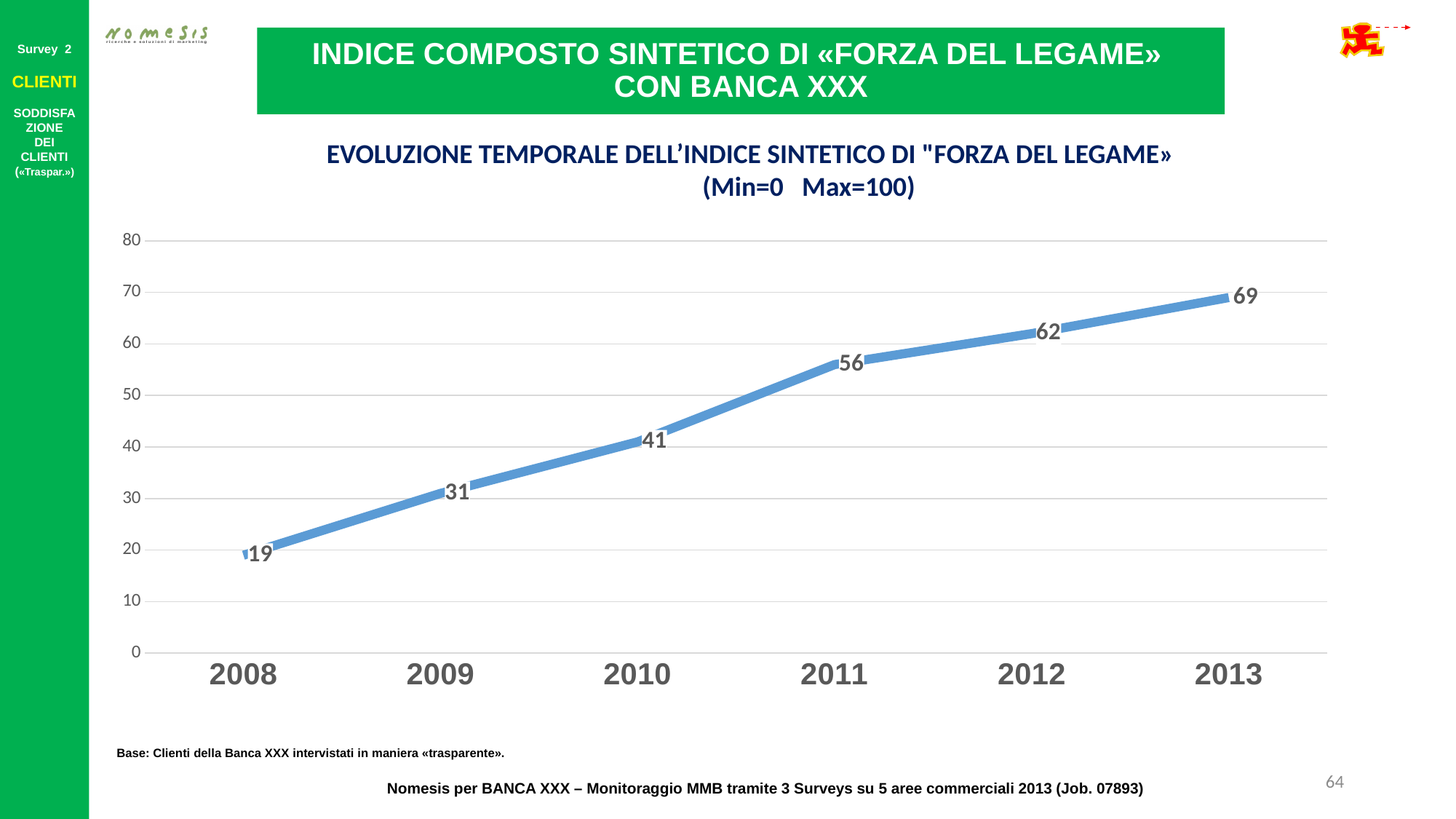
Does the index rise or fall from 2008 to 2013? rise What is the difference between the index values for 2013 and 2008? 50 What kind of chart is shown on the slide? line chart Which year has the lowest index value? 2008 How many years are plotted on the chart? 6 Which year has the highest index value? 2013 What is the difference between the index values for 2010 and 2009? 10 Which year has a higher index value, 2010 or 2012? 2012 What is the value of the index for 2011? 56 Is the value for 2011 greater or less than 50? greater What is the value of the index for 2013? 69 What is the value of the index for 2008? 19